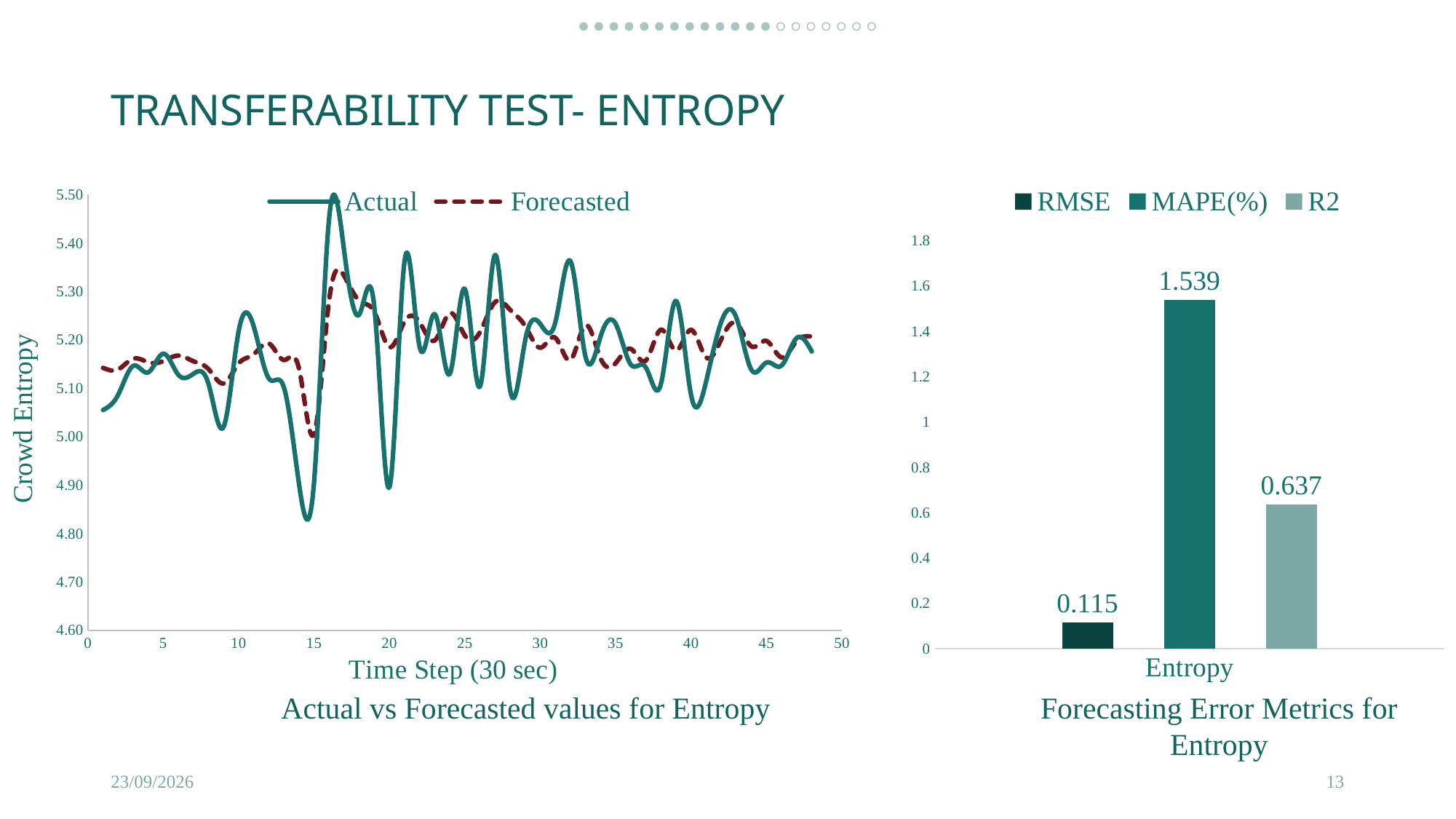
What kind of chart is the 'Actual vs Forecasted values for Entropy' chart? Line chart How many series does the legend of the 'Forecasting Error Metrics for Entropy' chart list? 3 How many series does the legend of the 'Actual vs Forecasted values for Entropy' chart list? 2 In the 'Forecasting Error Metrics for Entropy' chart, what is the difference between the MAPE(%) value and the R2 value? 0.902 What is the y-axis label of the 'Actual vs Forecasted values for Entropy' chart? Crowd Entropy In the 'Forecasting Error Metrics for Entropy' chart, what is the value of RMSE? 0.115 In the 'Forecasting Error Metrics for Entropy' chart, which metric has the lowest value? RMSE In the 'Forecasting Error Metrics for Entropy' chart, which metric has the highest value? MAPE(%) What kind of chart is the 'Forecasting Error Metrics for Entropy' chart? Bar chart In the 'Forecasting Error Metrics for Entropy' chart, what is the value of R2? 0.637 In the 'Forecasting Error Metrics for Entropy' chart, which is larger, RMSE or R2? R2 In the 'Forecasting Error Metrics for Entropy' chart, what is the value of MAPE(%)? 1.539